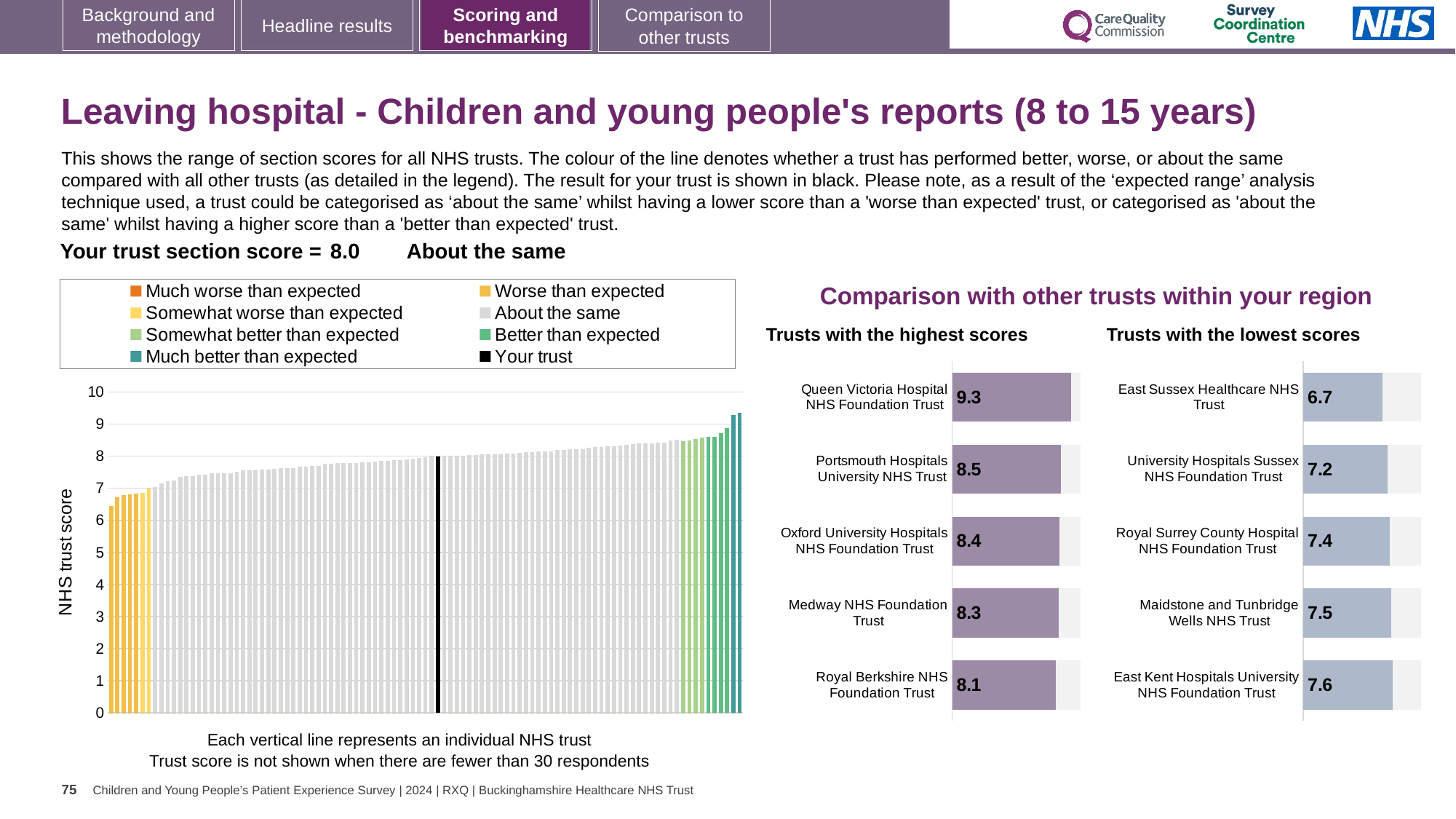
In the 'Trusts with the highest scores' chart, which trust has the highest score? Queen Victoria Hospital NHS Foundation Trust In the 'Trusts with the highest scores' chart, what is the score for Medway NHS Foundation Trust? 8.3 How many entries does the legend above the NHS trust score chart list? 8 In the 'Trusts with the lowest scores' chart, which trust has the lowest score? East Sussex Healthcare NHS Trust In the 'Trusts with the highest scores' chart, what is the difference between the scores of Queen Victoria Hospital NHS Foundation Trust and Royal Berkshire NHS Foundation Trust? 1.2 In the NHS trust score chart on the left, is the value of the tallest bar greater or less than 9? greater How many trusts are shown in the 'Trusts with the lowest scores' chart? 5 In the 'Trusts with the lowest scores' chart, what is the score for Maidstone and Tunbridge Wells NHS Trust? 7.5 In the NHS trust score chart on the left, do the bar values rise or fall from left to right? rise In the 'Trusts with the lowest scores' chart, what is the score for East Sussex Healthcare NHS Trust? 6.7 In the 'Trusts with the highest scores' chart, what is the score for Queen Victoria Hospital NHS Foundation Trust? 9.3 In the 'Trusts with the lowest scores' chart, which has the larger score: University Hospitals Sussex NHS Foundation Trust or East Kent Hospitals University NHS Foundation Trust? East Kent Hospitals University NHS Foundation Trust